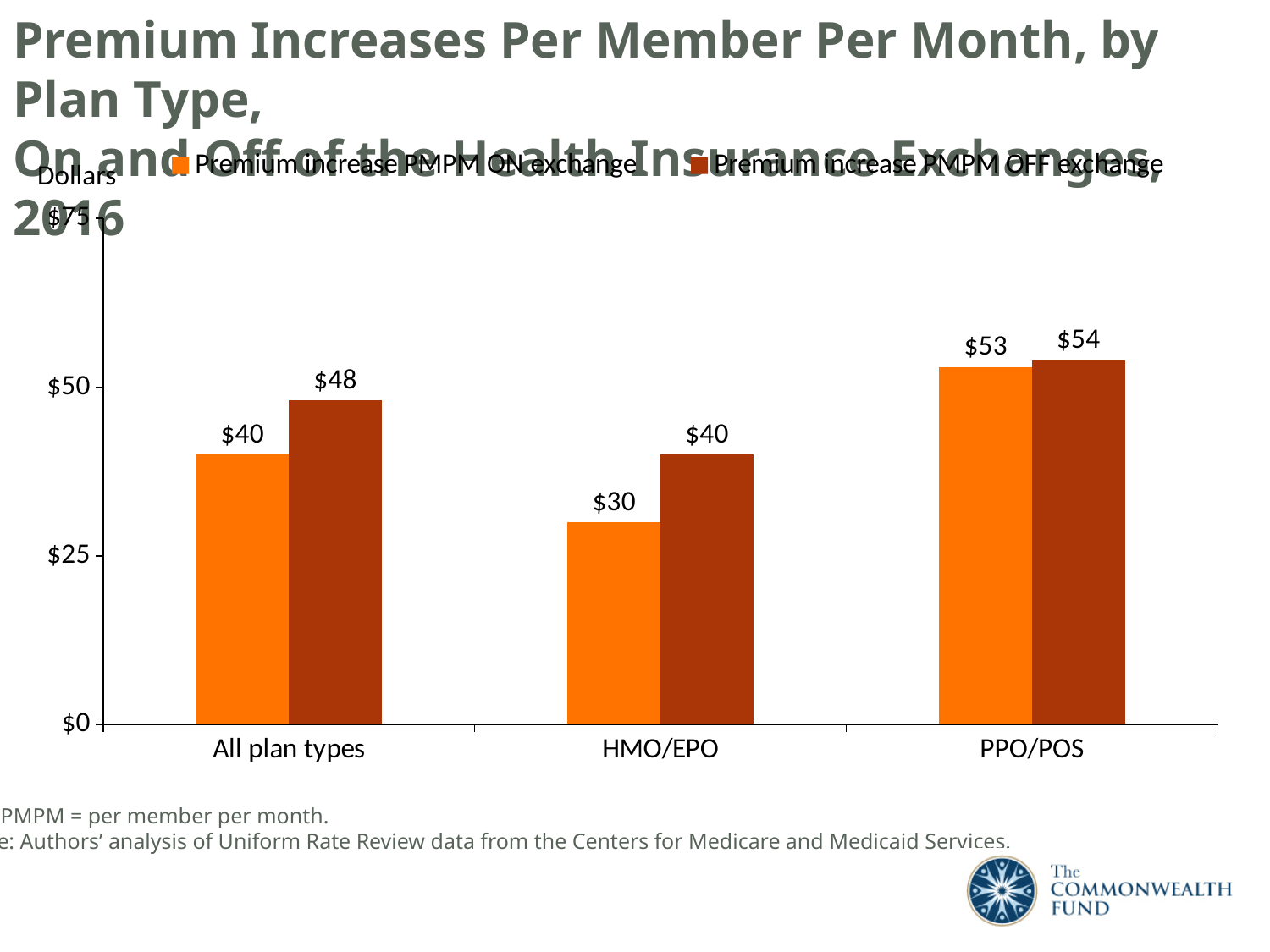
What is the difference between the OFF exchange and ON exchange premium increase for HMO/EPO? $10 What unit label is shown above the vertical axis? Dollars How many series does the legend list? 2 What kind of chart is shown on the slide? Bar chart Is the premium increase PMPM ON exchange for PPO/POS greater or less than $50? greater What is the premium increase PMPM OFF exchange for All plan types? $48 What is the premium increase PMPM OFF exchange for PPO/POS? $54 What is the premium increase PMPM ON exchange for HMO/EPO? $30 How many plan type categories are shown on the x axis? 3 Which plan type has the lowest premium increase PMPM OFF exchange? HMO/EPO Which is larger for All plan types: the ON exchange or the OFF exchange premium increase? OFF exchange Which plan type has the highest premium increase PMPM ON exchange? PPO/POS